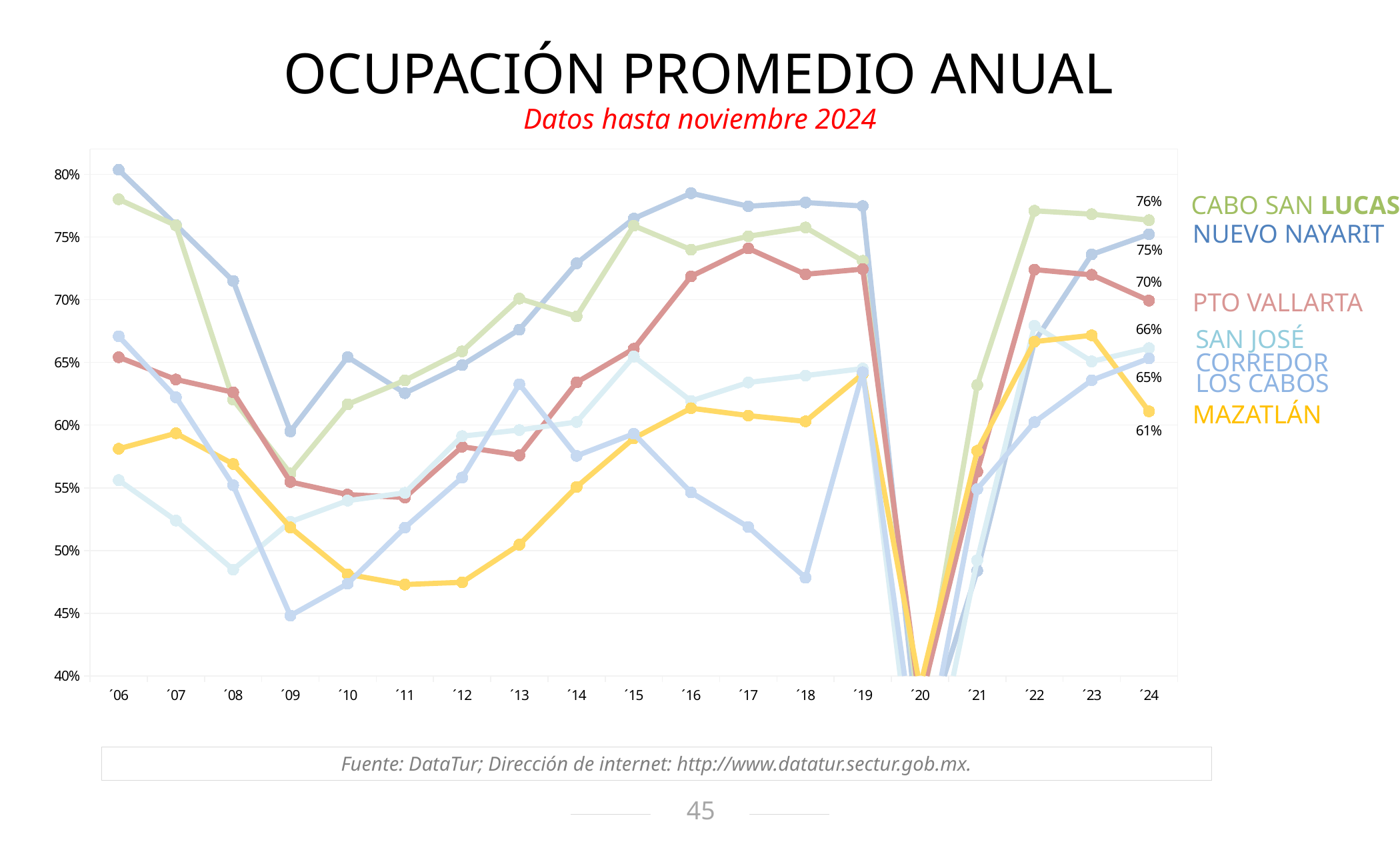
What kind of chart is shown on the slide? line chart Which destination has the highest occupancy in 2024? Cabo San Lucas How many destinations (series) does the legend list? 6 What is the 2024 occupancy value shown for Cabo San Lucas? 76% Which destination has the lowest occupancy in 2024? Mazatlán In 2024, which is higher: Nuevo Nayarit or Pto Vallarta? Nuevo Nayarit What is the 2024 occupancy value shown for Mazatlán? 61% What is the difference between the 2024 values for Cabo San Lucas and Mazatlán? 15 percentage points Does the Mazatlán line rise or fall between 2011 and 2016? rise What is the 2024 occupancy value shown for Pto Vallarta? 70% Is the value for Corredor Los Cabos in 2009 greater or less than 50%? less How many years are shown on the x axis? 19